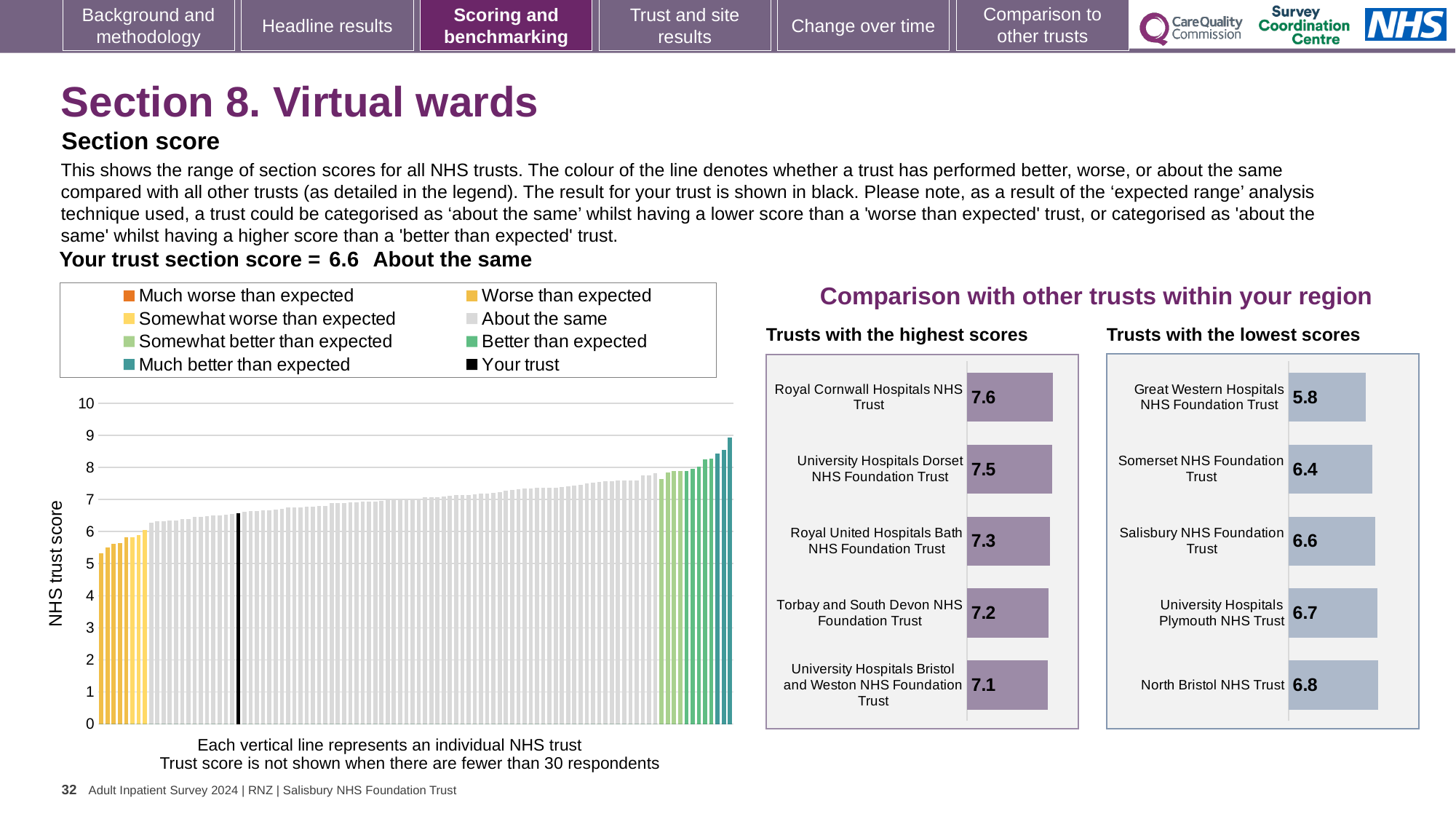
In the 'Trusts with the highest scores' chart, which trust has the lowest score? University Hospitals Bristol and Weston NHS Foundation Trust In the 'Trusts with the highest scores' chart, what is the score for Royal Cornwall Hospitals NHS Trust? 7.6 In the 'Trusts with the highest scores' chart, which has a higher score: Royal United Hospitals Bath NHS Foundation Trust or Torbay and South Devon NHS Foundation Trust? Royal United Hospitals Bath NHS Foundation Trust In the 'Trusts with the lowest scores' chart, what is the difference between the scores of Somerset NHS Foundation Trust and Great Western Hospitals NHS Foundation Trust? 0.6 How many trusts are shown in the 'Trusts with the lowest scores' chart? 5 In the large 'NHS trust score' chart on the left, what is the section score for your trust (the black bar)? 6.6 In the 'Trusts with the highest scores' chart, what is the difference between the scores of Royal Cornwall Hospitals NHS Trust and University Hospitals Bristol and Weston NHS Foundation Trust? 0.5 In the 'Trusts with the lowest scores' chart, what is the score for North Bristol NHS Trust? 6.8 In the large 'NHS trust score' chart on the left, is the value of the highest bar greater or less than 8? greater How many entries does the legend of the large 'NHS trust score' chart on the left list? 8 In the 'Trusts with the lowest scores' chart, what is the score for Great Western Hospitals NHS Foundation Trust? 5.8 In the 'Trusts with the lowest scores' chart, which trust has the lowest score? Great Western Hospitals NHS Foundation Trust